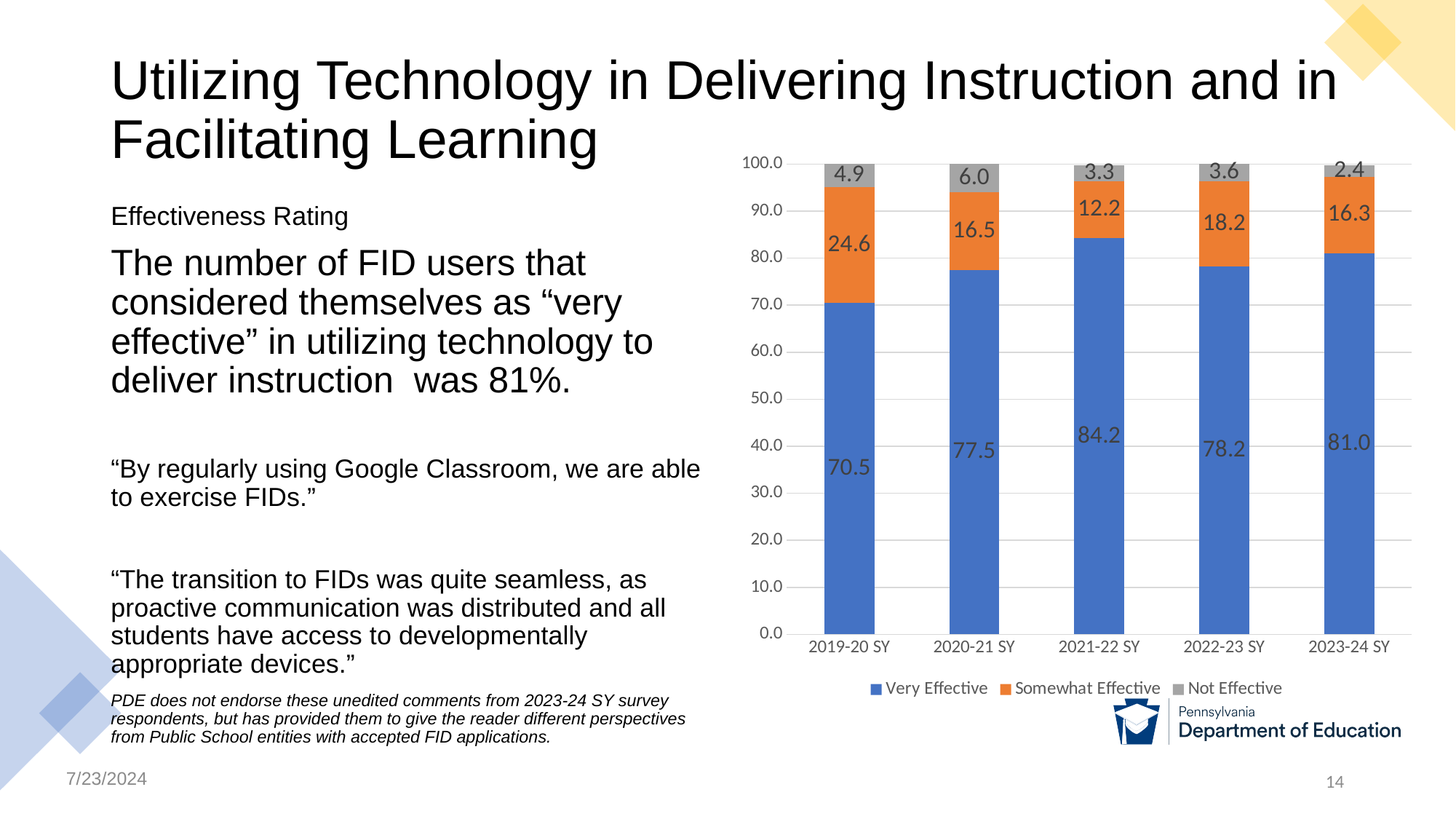
Which school year has the lowest Not Effective value? 2023-24 SY What is the Not Effective value for 2020-21 SY? 6.0 How many series does the legend list? 3 What is the Very Effective value for 2023-24 SY? 81.0 How many school years are shown on the x axis? 5 What is the difference between the Very Effective values for 2021-22 SY and 2019-20 SY? 13.7 Which series is shown in orange in the legend? Somewhat Effective What is the Somewhat Effective value for 2019-20 SY? 24.6 Which is larger, the Somewhat Effective value for 2022-23 SY or for 2020-21 SY? 2022-23 SY Which school year has the highest Very Effective value? 2021-22 SY What kind of chart is shown on the slide? Stacked bar chart What is the total of the stacked bar for 2020-21 SY? 100.0